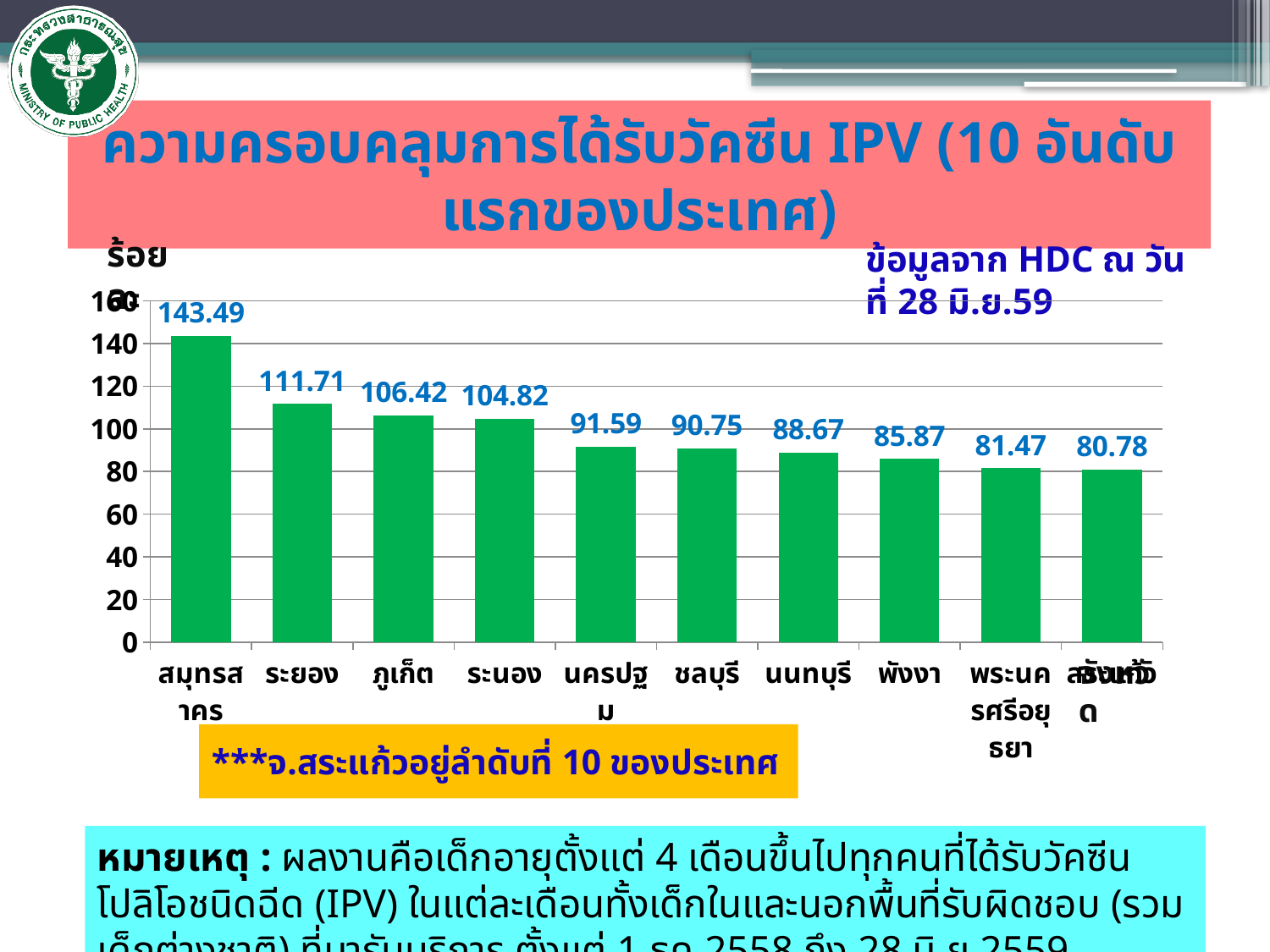
Is the value for พังงา greater or less than 100? less Do the values rise or fall from left to right across the chart? fall What is the value for ระยอง? 111.71 What is the value for พระนครศรีอยุธยา? 81.47 Which province has the highest value in the chart? สมุทรสาคร How many provinces (bars) are shown in the chart? 10 Which is larger, the value for ชลบุรี or the value for นนทบุรี? ชลบุรี What is the value for สมุทรสาคร? 143.49 What type of chart is shown on the slide? bar chart What is the difference between the values for ภูเก็ต and ระนอง? 1.60 What is the value for นครปฐม? 91.59 What is the value of the rightmost (lowest) bar in the chart? 80.78